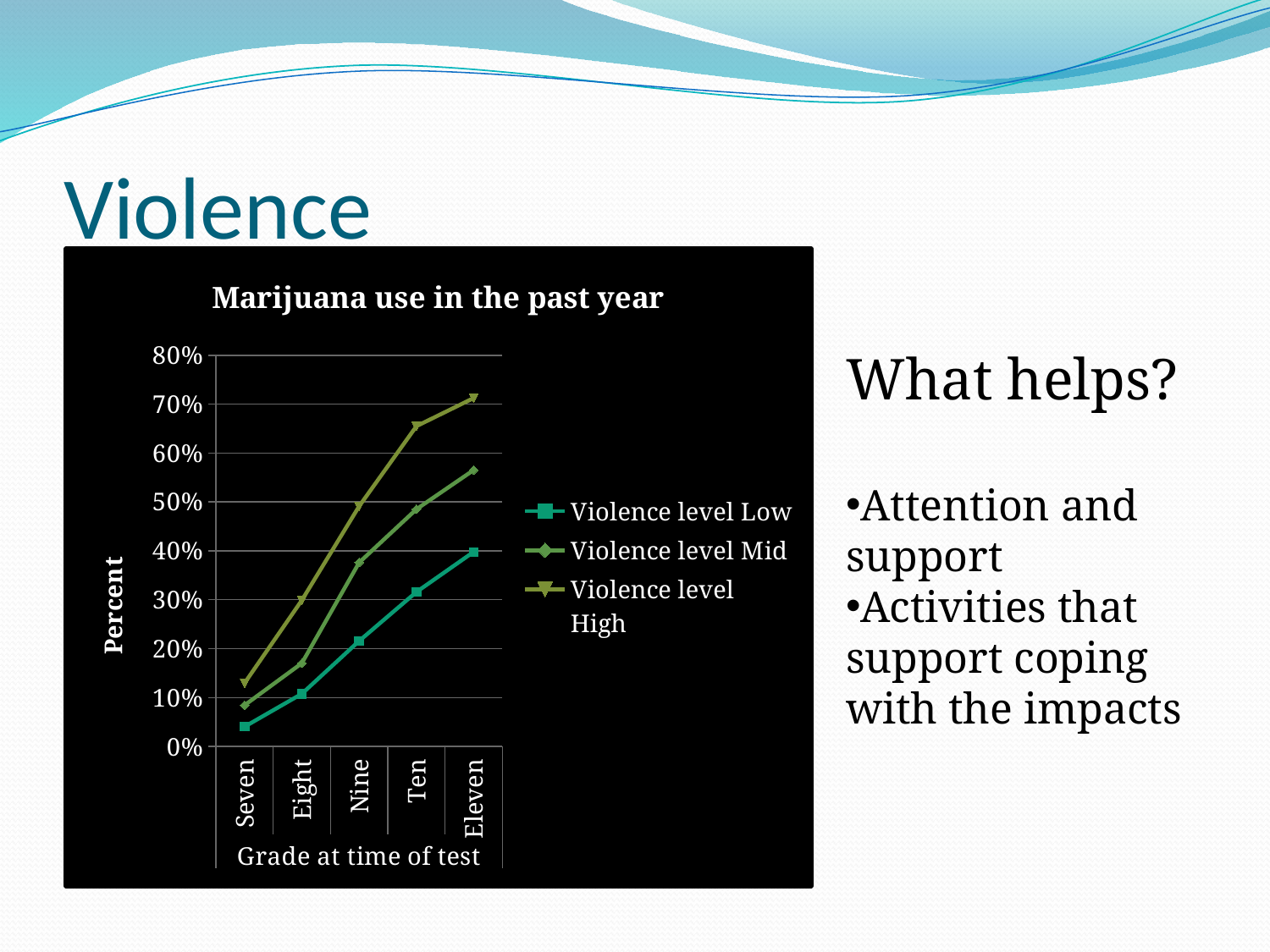
What kind of chart is shown on the slide? line chart For Violence level Low, which grade has the lowest value? Seven Which series has the highest value at grade Eleven? Violence level High What is the title of the chart? Marijuana use in the past year At grade Nine, which is larger: Violence level Mid or Violence level Low? Violence level Mid Is the value for Violence level Low at grade Eleven greater or less than 50%? less Is the value for Violence level Mid at grade Nine greater or less than 30%? greater What is the label of the x axis? Grade at time of test How many grade categories are shown on the x axis? 5 How many series does the legend list? 3 Is the value for Violence level High at grade Eleven greater or less than 60%? greater Do the values for Violence level High rise or fall from grade Seven to grade Eleven? rise